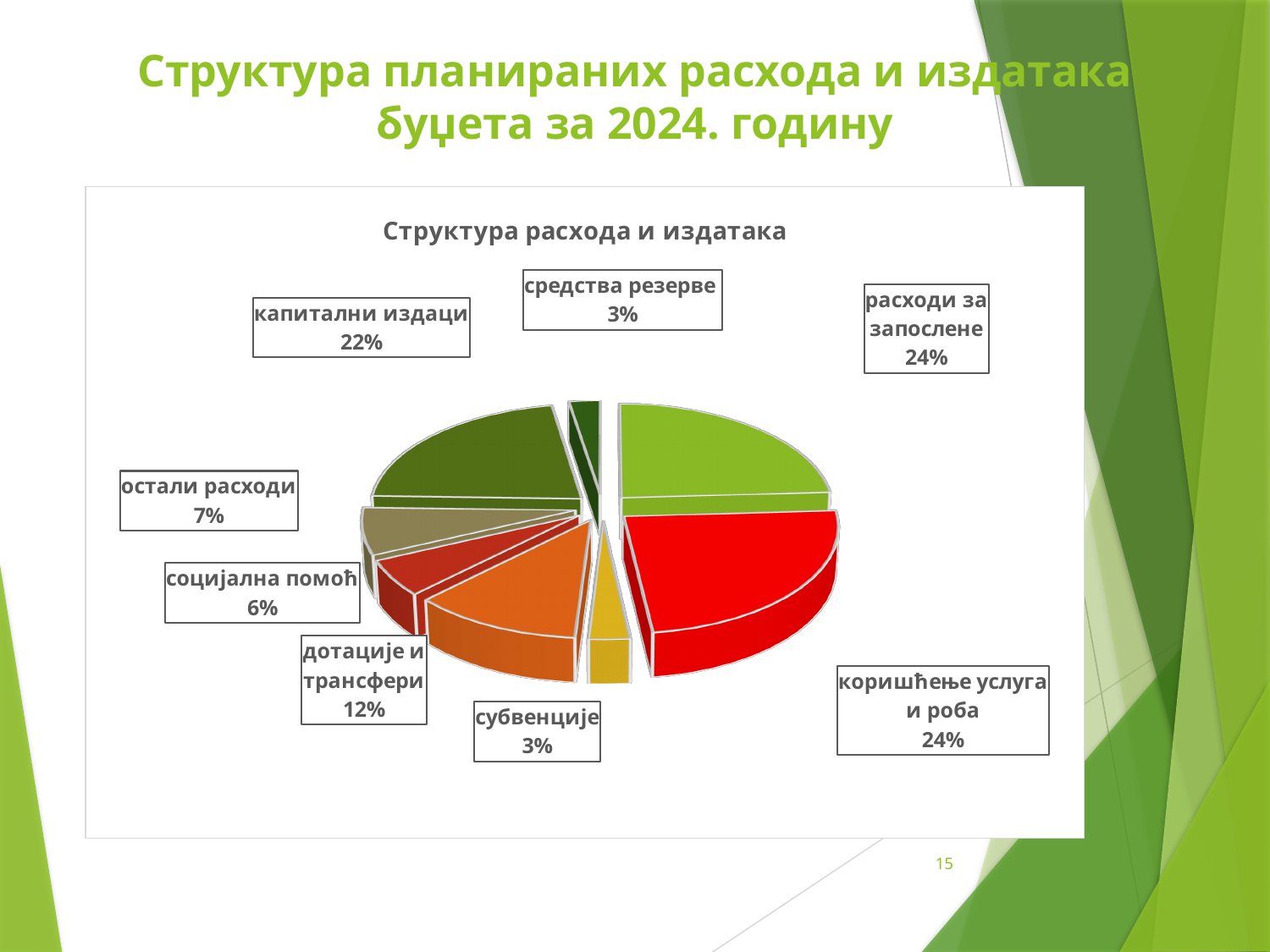
What is the title of the chart? Структура расхода и издатака What is the difference in percentage points between "расходи за запослене" and "дотације и трансфери"? 12 What share of the pie chart does "капитални издаци" represent? 22% What percentage is shown for "средства резерве"? 3% Which is larger, the share for "капитални издаци" or the share for "дотације и трансфери"? капитални издаци What percentage is shown for "дотације и трансфери"? 12% What percentage is shown for "расходи за запослене"? 24% What share does "социјална помоћ" have in the chart? 6% Which is larger, "остали расходи" or "социјална помоћ"? остали расходи What percentage is labelled for "остали расходи"? 7% How many categories (slices) does the pie chart show? 8 What type of chart is shown on the slide? Pie chart